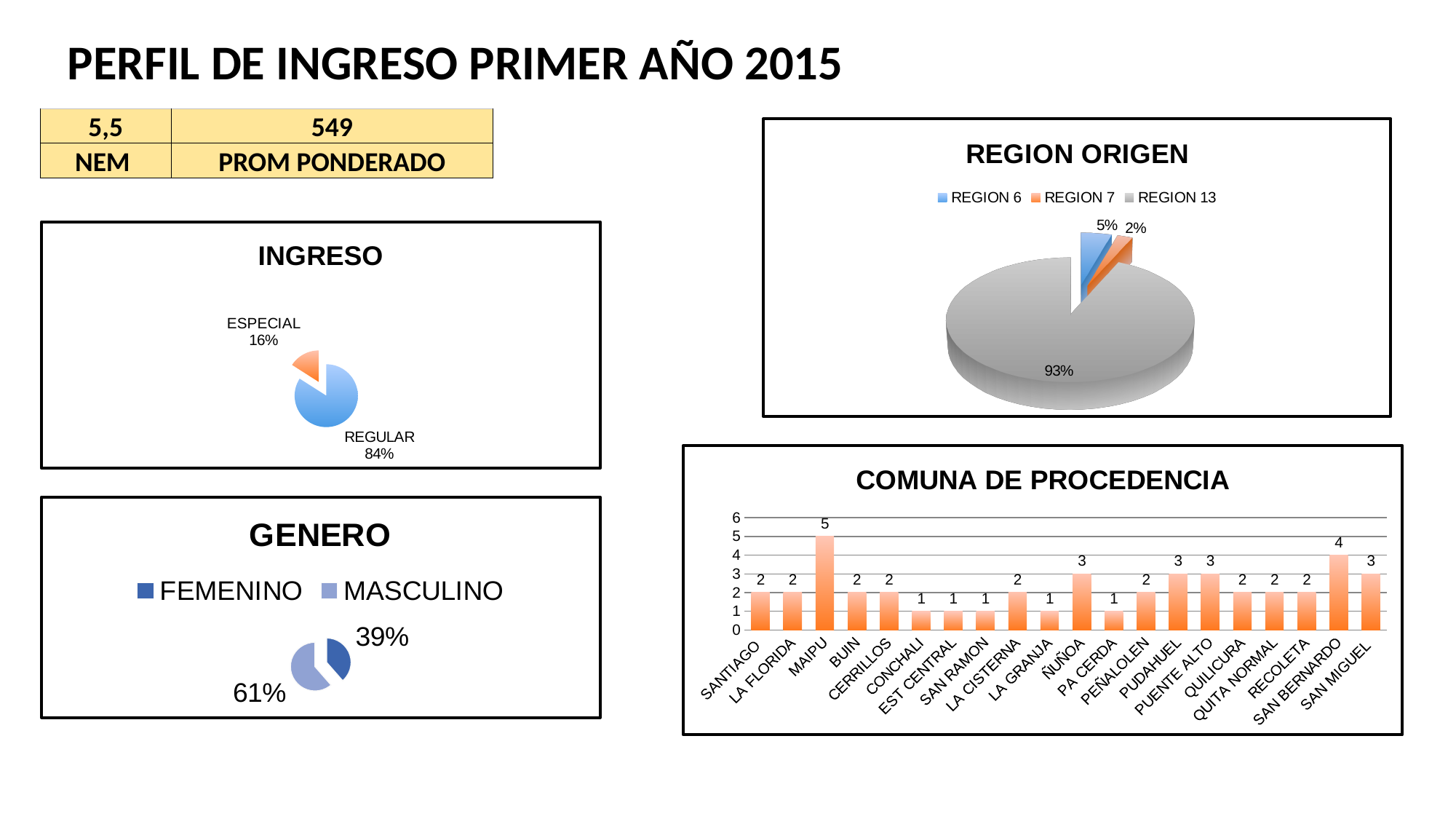
In the INGRESO chart, what share is REGULAR? 84% In the COMUNA DE PROCEDENCIA chart, what is the value for SAN BERNARDO? 4 What kind of chart is the COMUNA DE PROCEDENCIA chart? bar chart How many series does the legend of the REGION ORIGEN chart list? 3 In the COMUNA DE PROCEDENCIA chart, which comuna has the highest value? MAIPU In the INGRESO chart, what share is ESPECIAL? 16% In the COMUNA DE PROCEDENCIA chart, which is larger, PUENTE ALTO or RECOLETA? PUENTE ALTO In the REGION ORIGEN chart, what share is REGION 13? 93% In the COMUNA DE PROCEDENCIA chart, what is the difference between MAIPU and ÑUÑOA? 2 How many comunas are shown in the COMUNA DE PROCEDENCIA chart? 20 In the REGION ORIGEN chart, which region has the smallest share? REGION 7